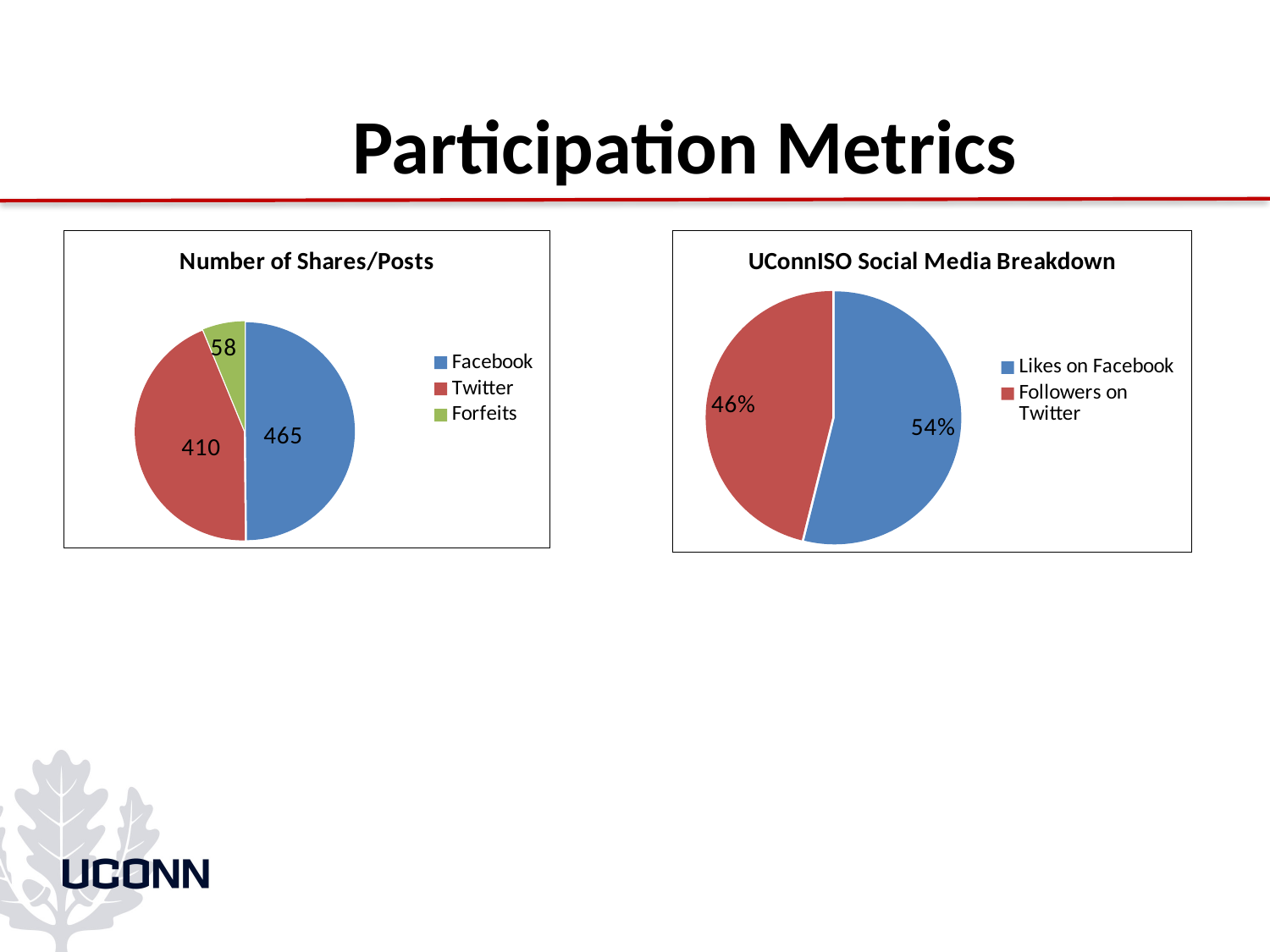
In the "UConnISO Social Media Breakdown" chart, what share is Likes on Facebook? 54% In the "Number of Shares/Posts" chart, what is the value for Forfeits? 58 In the "Number of Shares/Posts" chart, what is the difference between the Facebook and Twitter values? 55 In the "UConnISO Social Media Breakdown" chart, what share is Followers on Twitter? 46% In the "UConnISO Social Media Breakdown" chart, how many entries does the legend list? 2 In the "Number of Shares/Posts" chart, what is the value for Twitter? 410 In the "Number of Shares/Posts" chart, what is the value for Facebook? 465 What kind of chart is the "Number of Shares/Posts" chart? Pie chart In the "Number of Shares/Posts" chart, which category has the smallest slice? Forfeits In the "Number of Shares/Posts" chart, how many categories are shown? 3 In the "Number of Shares/Posts" chart, which category has the largest slice? Facebook In the "UConnISO Social Media Breakdown" chart, which is larger, Likes on Facebook or Followers on Twitter? Likes on Facebook